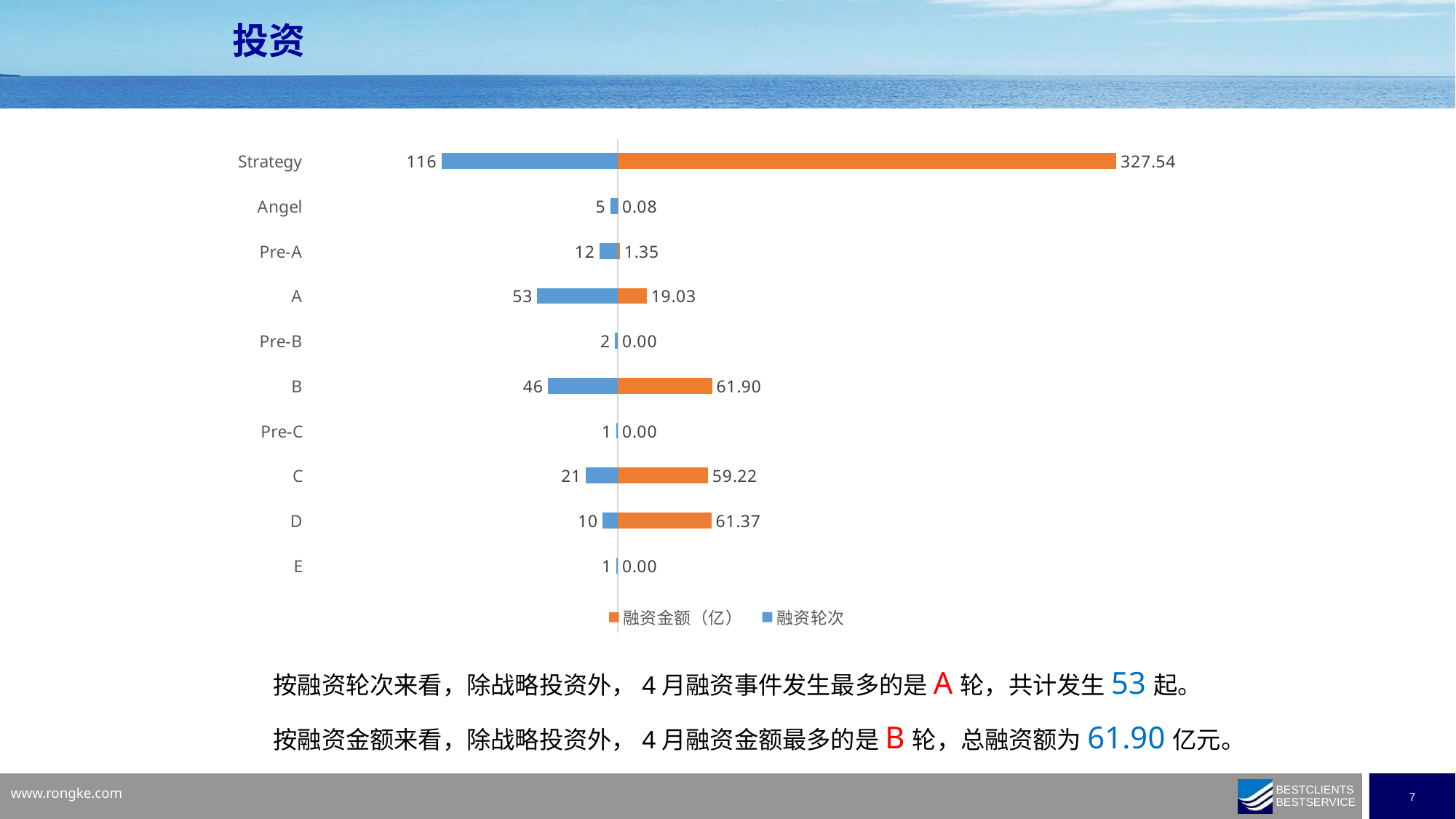
What is the 融资金额（亿） value for the B category? 61.90 Which colour represents the 融资轮次 series in the chart? Blue Which category has the lowest 融资轮次 value? Pre-C and E (both 1) What is the 融资轮次 value for the A category? 53 How many categories are shown on the chart? 10 How many series does the legend list? 2 What is the difference between the 融资轮次 values for Strategy and A? 63 Which has a larger 融资金额（亿） value, B or D? B What is the 融资金额（亿） value for the Strategy category? 327.54 What is the 融资轮次 value for the C category? 21 Which category has the highest 融资金额（亿） value? Strategy What kind of chart is shown on the slide? Bar chart